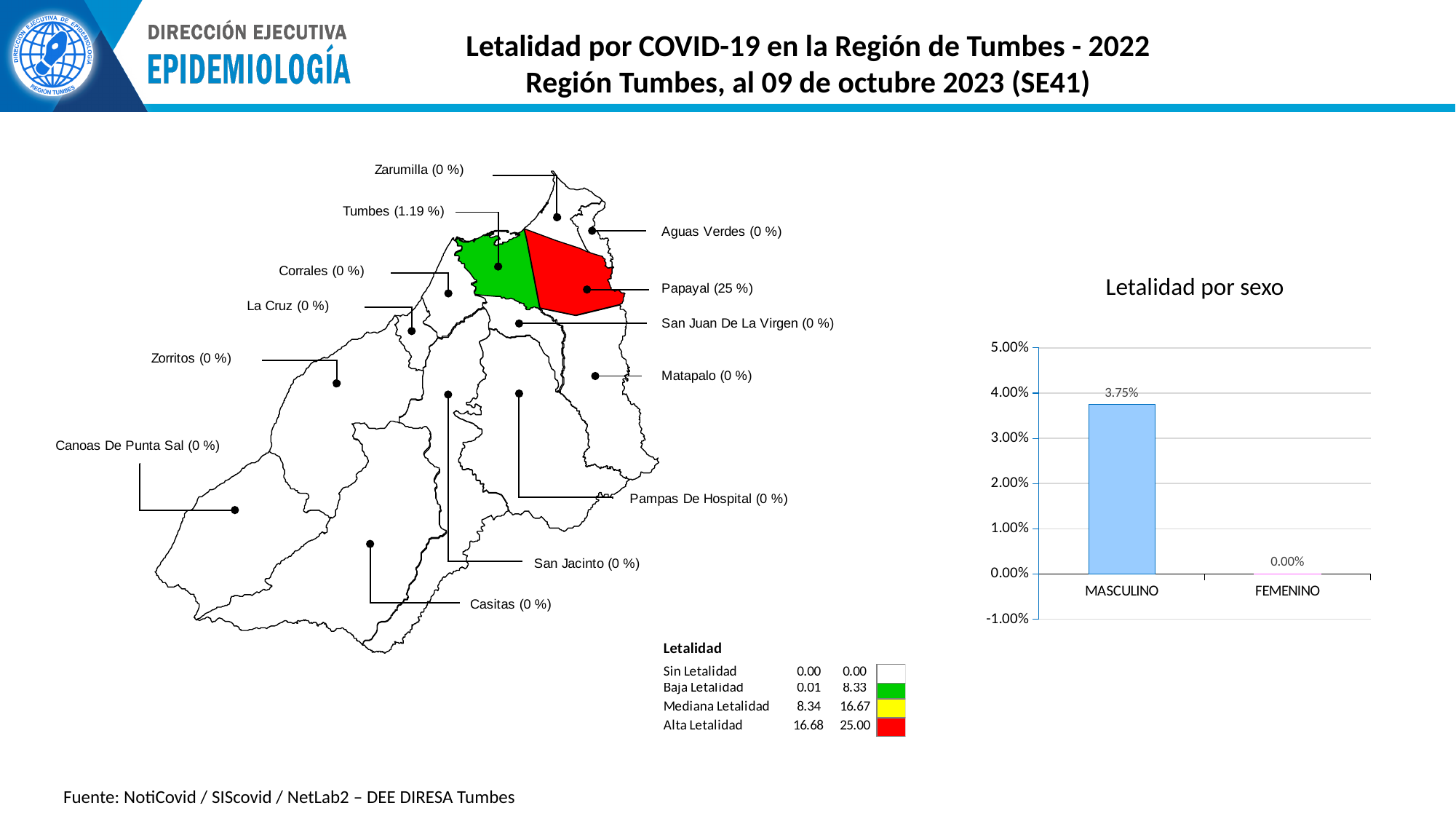
In the 'Letalidad por sexo' chart, which category has the highest value? MASCULINO In the 'Letalidad por sexo' chart, which category has the lowest value? FEMENINO What is the title of the chart on the right side of the slide? Letalidad por sexo On the map legend, which colour represents 'Alta Letalidad'? red In the 'Letalidad por sexo' chart, is the value for MASCULINO greater or less than 3.00%? greater On the map, what lethality percentage is shown for Tumbes? 1.19 % In the 'Letalidad por sexo' chart, what is the value for MASCULINO? 3.75% On the map, which district is labelled with the highest lethality percentage? Papayal (25 %) In the 'Letalidad por sexo' chart, what is the difference between the MASCULINO and FEMENINO values? 3.75% In the 'Letalidad por sexo' chart, what is the value for FEMENINO? 0.00% What kind of chart is 'Letalidad por sexo'? bar chart How many categories are shown in the 'Letalidad por sexo' chart? 2